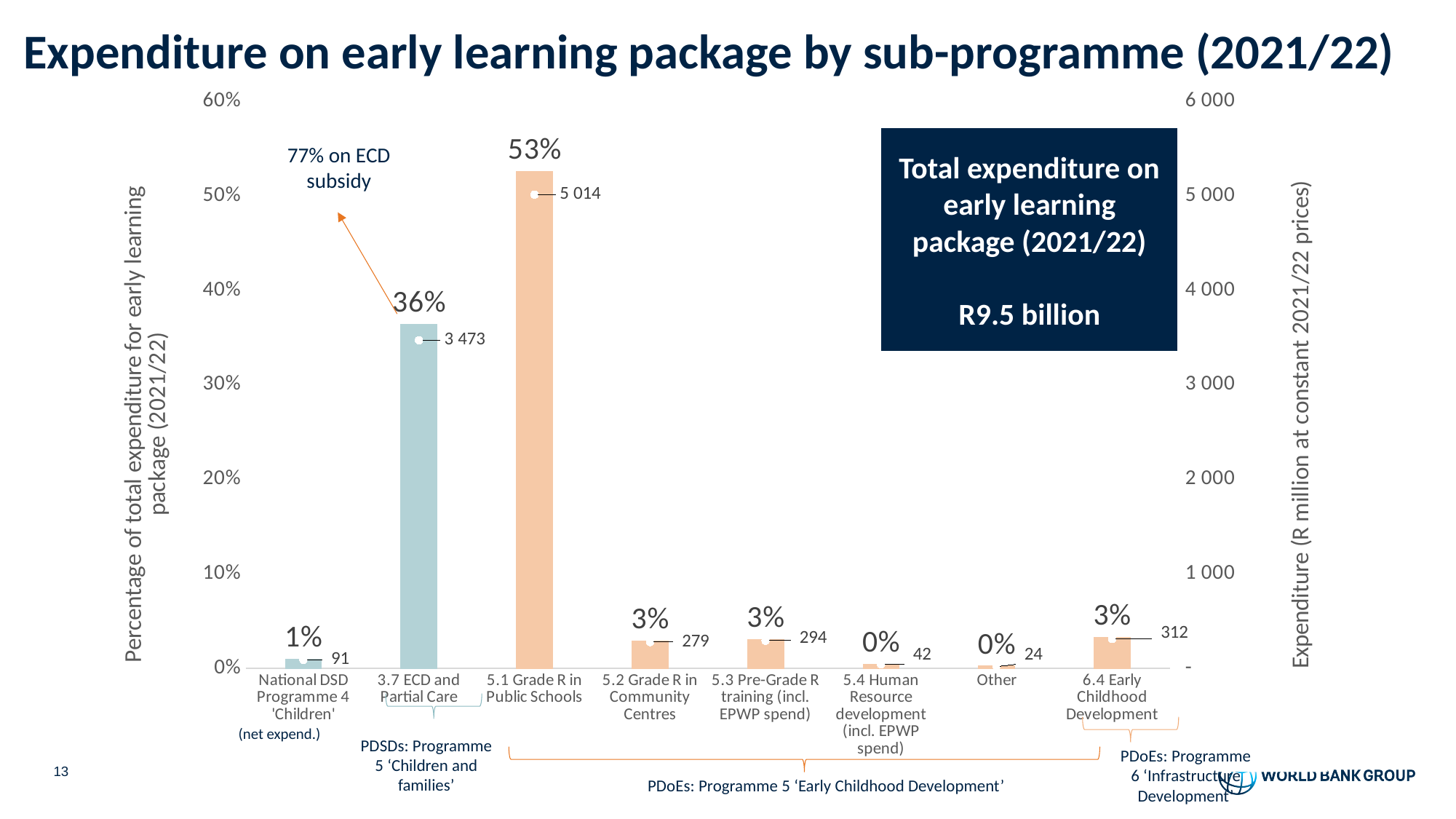
According to the annotation, what percentage of 3.7 ECD and Partial Care expenditure is on the ECD subsidy? 77% Which category has the lowest expenditure value in R million? Other What percentage of total expenditure is shown for 5.1 Grade R in Public Schools? 53% What percentage of total expenditure is shown for National DSD Programme 4 'Children'? 1% Which has the larger expenditure: 5.3 Pre-Grade R training (incl. EPWP spend) or 5.2 Grade R in Community Centres? 5.3 Pre-Grade R training (incl. EPWP spend) What expenditure value (R million) is labelled for 6.4 Early Childhood Development? 312 What kind of chart is shown on the slide? Bar chart What total expenditure on the early learning package (2021/22) is stated in the box on the slide? R9.5 billion What is the expenditure in R million shown for 3.7 ECD and Partial Care? 3 473 What is the difference in R million between 5.1 Grade R in Public Schools and 3.7 ECD and Partial Care? 1 541 Which sub-programme has the highest share of total expenditure? 5.1 Grade R in Public Schools How many sub-programme categories are plotted on the x axis? 8